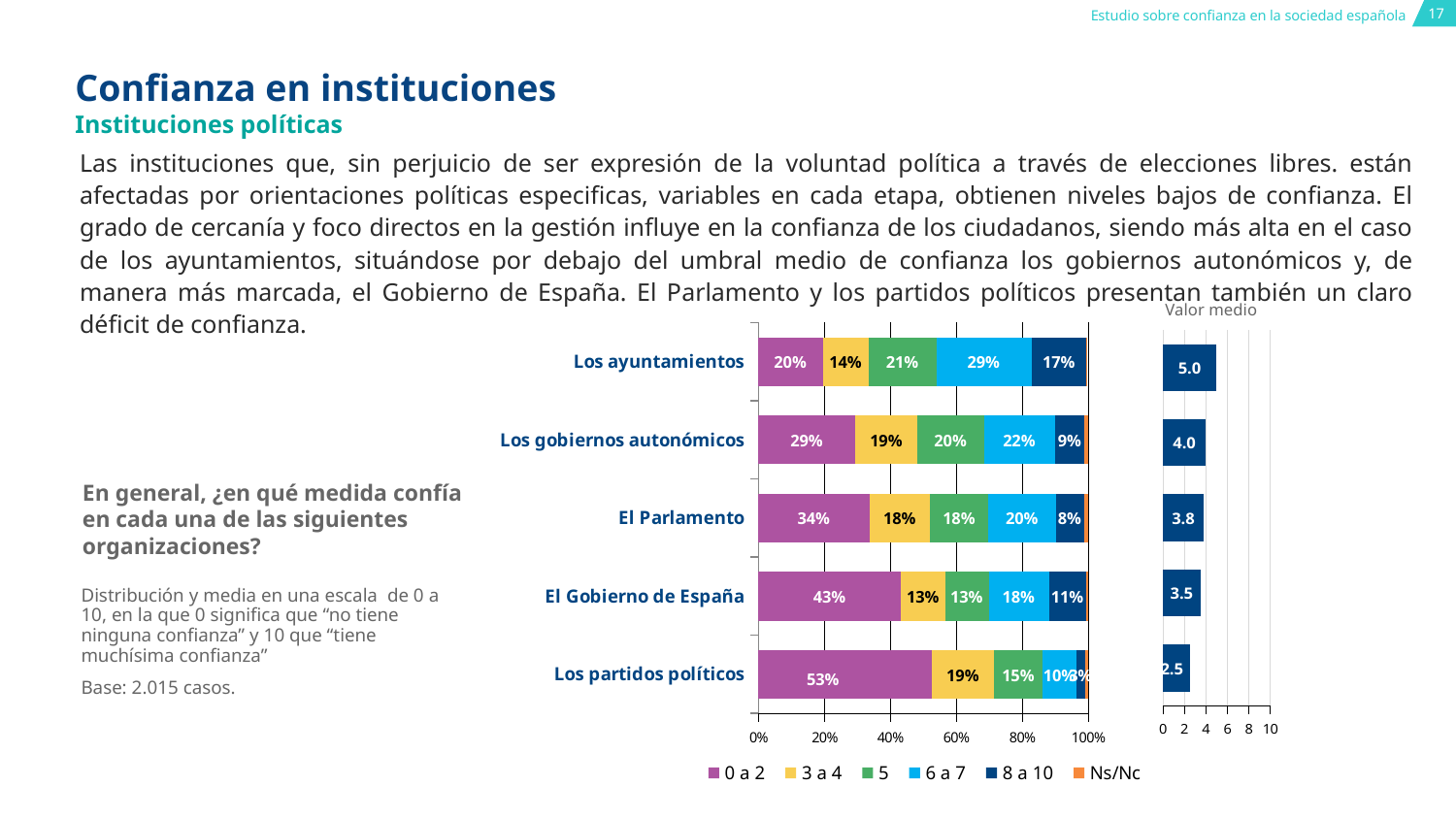
In the stacked bar chart on the left, which has a larger share of 0 a 2 responses: El Parlamento or El Gobierno de España? El Gobierno de España In the 'Valor medio' chart, what is the difference between the mean value for Los ayuntamientos and the mean value for Los partidos políticos? 2.5 In the 'Valor medio' chart, which institution has the lowest mean value? Los partidos políticos In the stacked bar chart on the left, how many institutions are shown? 5 In the 'Valor medio' chart, what is the mean value for Los ayuntamientos? 5.0 In the stacked bar chart on the left, what percentage of respondents gave Los partidos políticos a score of 0 a 2? 53% How many series does the legend of the stacked bar chart list? 6 In the 'Valor medio' chart, do the mean values rise or fall going from Los ayuntamientos at the top to Los partidos políticos at the bottom? Fall In the 'Valor medio' chart, which institution has the highest mean value? Los ayuntamientos What kind of chart is the chart on the left showing the distribution of responses? Stacked bar chart In the stacked bar chart on the left, what percentage gave Los ayuntamientos a score of 8 a 10? 17% In the stacked bar chart on the left, what percentage gave Los gobiernos autonómicos a score of 6 a 7? 22%